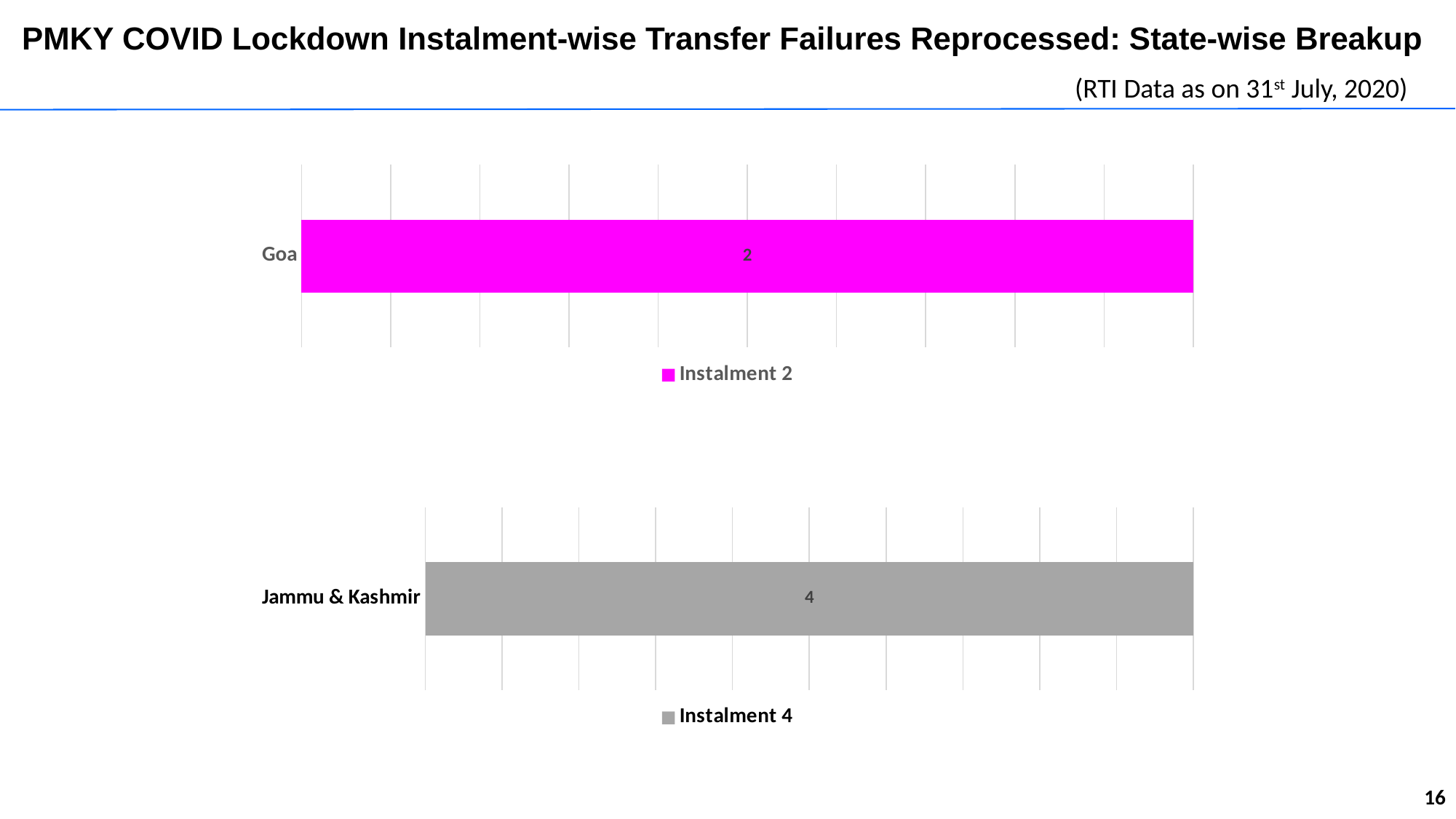
What kind of chart is the top chart? Bar chart In the bottom chart, what series name does the legend show? Instalment 4 In the bottom chart, how many categories are plotted? 1 In the bottom chart, how many series does the legend list? 1 In the bottom chart, what is the value for Jammu & Kashmir? 4 In the top chart, how many series does the legend list? 1 Which is larger: the value for Goa in the top chart or the value for Jammu & Kashmir in the bottom chart? Jammu & Kashmir In the top chart, what is the value for Goa? 2 What is the difference between the value for Jammu & Kashmir in the bottom chart and the value for Goa in the top chart? 2 What kind of chart is the bottom chart? Bar chart In the top chart, how many categories are plotted? 1 In the top chart, what series name does the legend show? Instalment 2